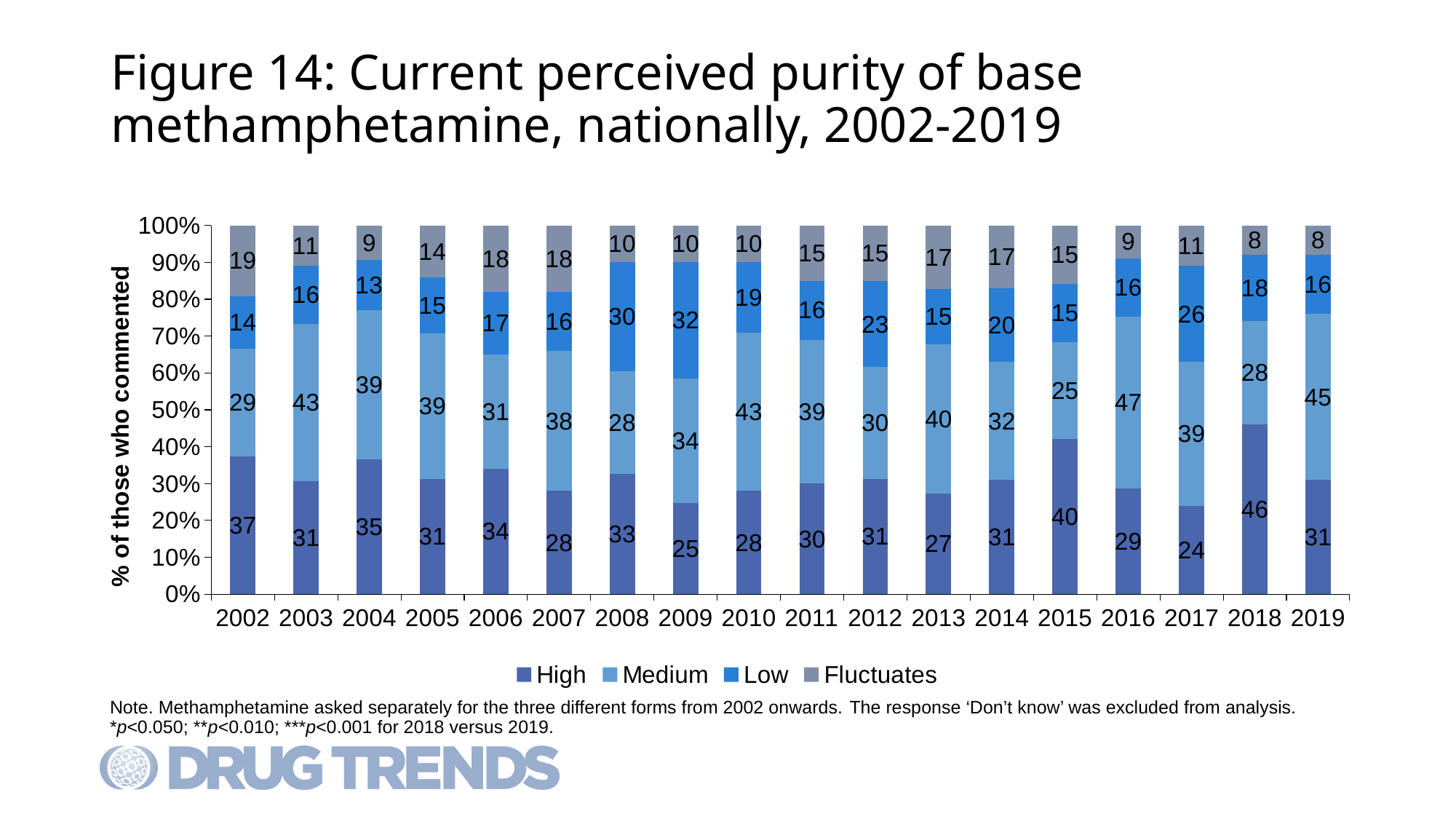
What is the Low value for 2009? 32 What is the Fluctuates value for 2002? 19 What is the difference between the High value in 2018 and the High value in 2019? 15 Which is larger, the Low value in 2008 or the Low value in 2010? 2008 In which year is the Medium value the largest? 2016 What is the Medium value for 2016? 47 In which year is the High value the smallest? 2017 How many series does the legend list? 4 How many years are shown on the x axis? 18 What kind of chart is shown on the slide? Stacked bar chart What percentage of those who commented rated the purity of base methamphetamine as High in 2018? 46 In which year is the High value the largest? 2018